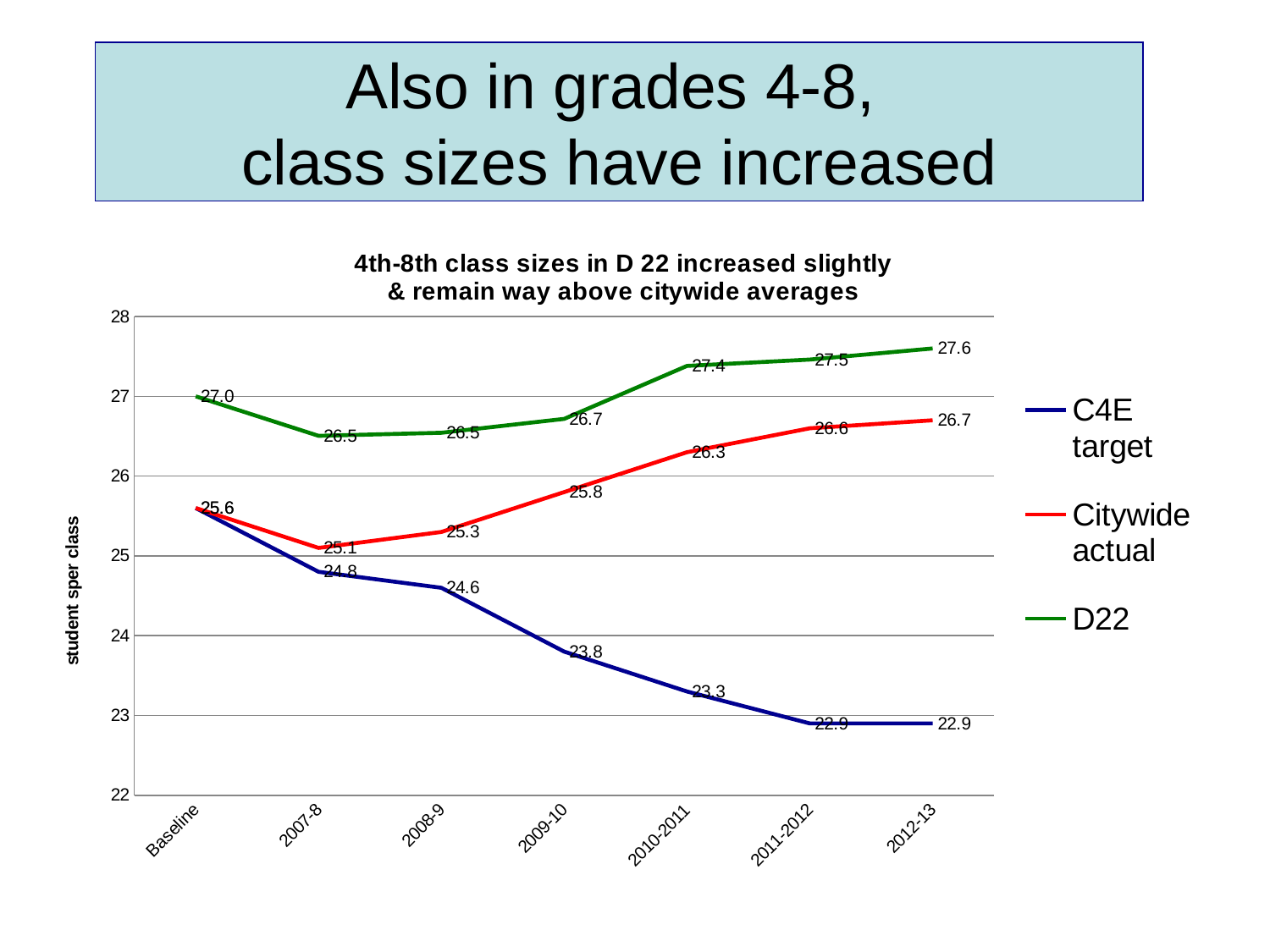
In which year does the D22 series reach its highest value? 2012-13 In which year is the Citywide actual series at its lowest value? 2007-8 What is the D22 value at Baseline? 27.0 What is the label on the vertical axis? student sper class What type of chart is shown on the slide? line chart What is the difference between the D22 value and the Citywide actual value in 2012-13? 0.9 What is the Citywide actual value for 2010-2011? 26.3 How many series does the legend list? 3 How many points are plotted along the x axis for each series? 7 Which is larger in 2009-10, the Citywide actual value or the C4E target value? Citywide actual What is the C4E target value for 2012-13? 22.9 Does the C4E target series rise or fall from Baseline to 2012-13? fall